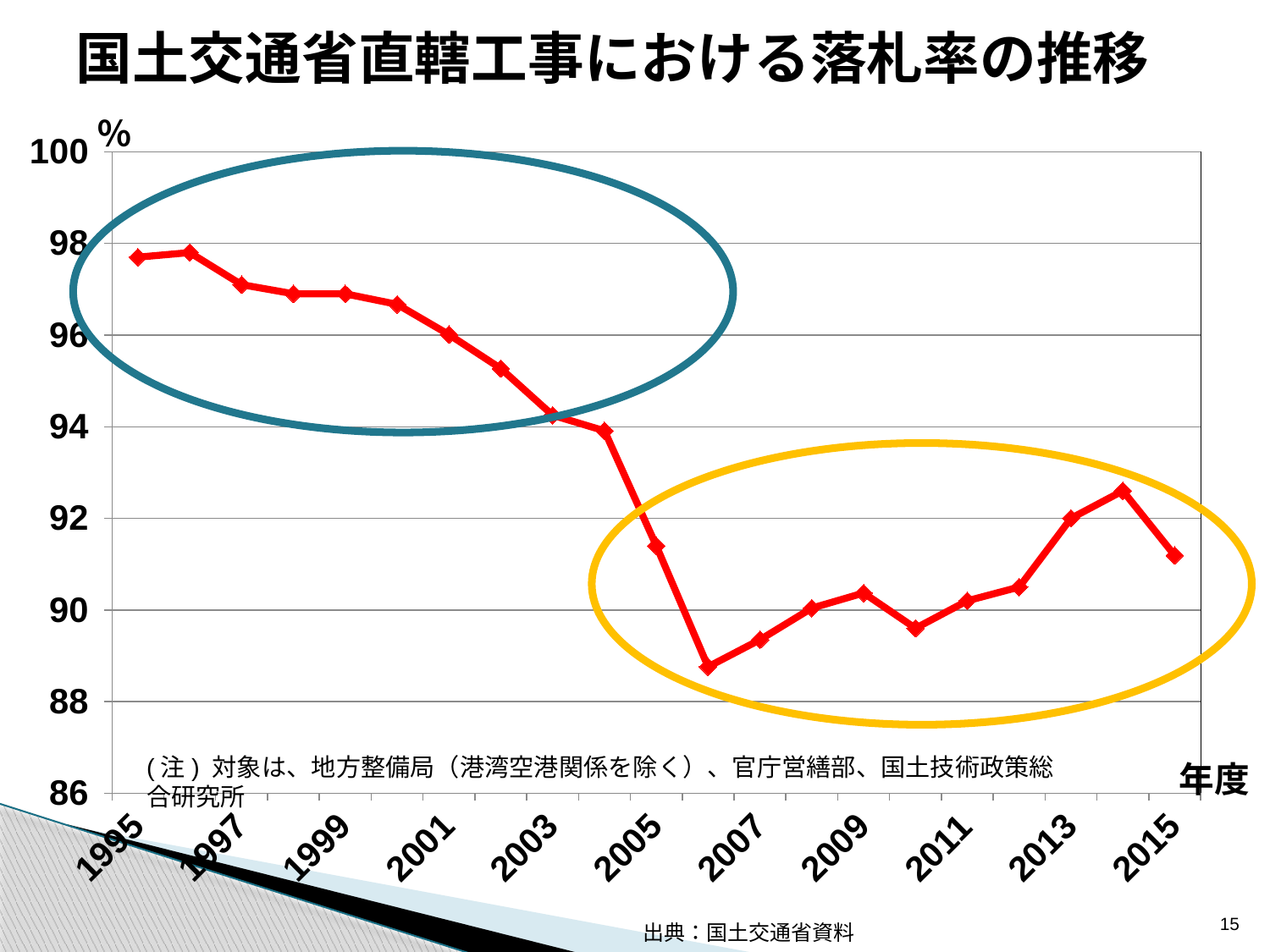
Is the value for 2005 greater or less than 92? less Which is larger, the value for 1995 or the value for 2015? 1995 Do the values rise or fall from 1995 to 2006? fall Is the value for 2013 greater or less than 90? greater Is the value for 2015 greater or less than 90? greater What is the title of the chart? 国土交通省直轄工事における落札率の推移 Which year has the lowest value on the chart? 2006 Which is larger, the value for 2005 or the value for 2007? 2005 What unit is shown at the top of the vertical axis? % What kind of chart is shown on the slide? line chart